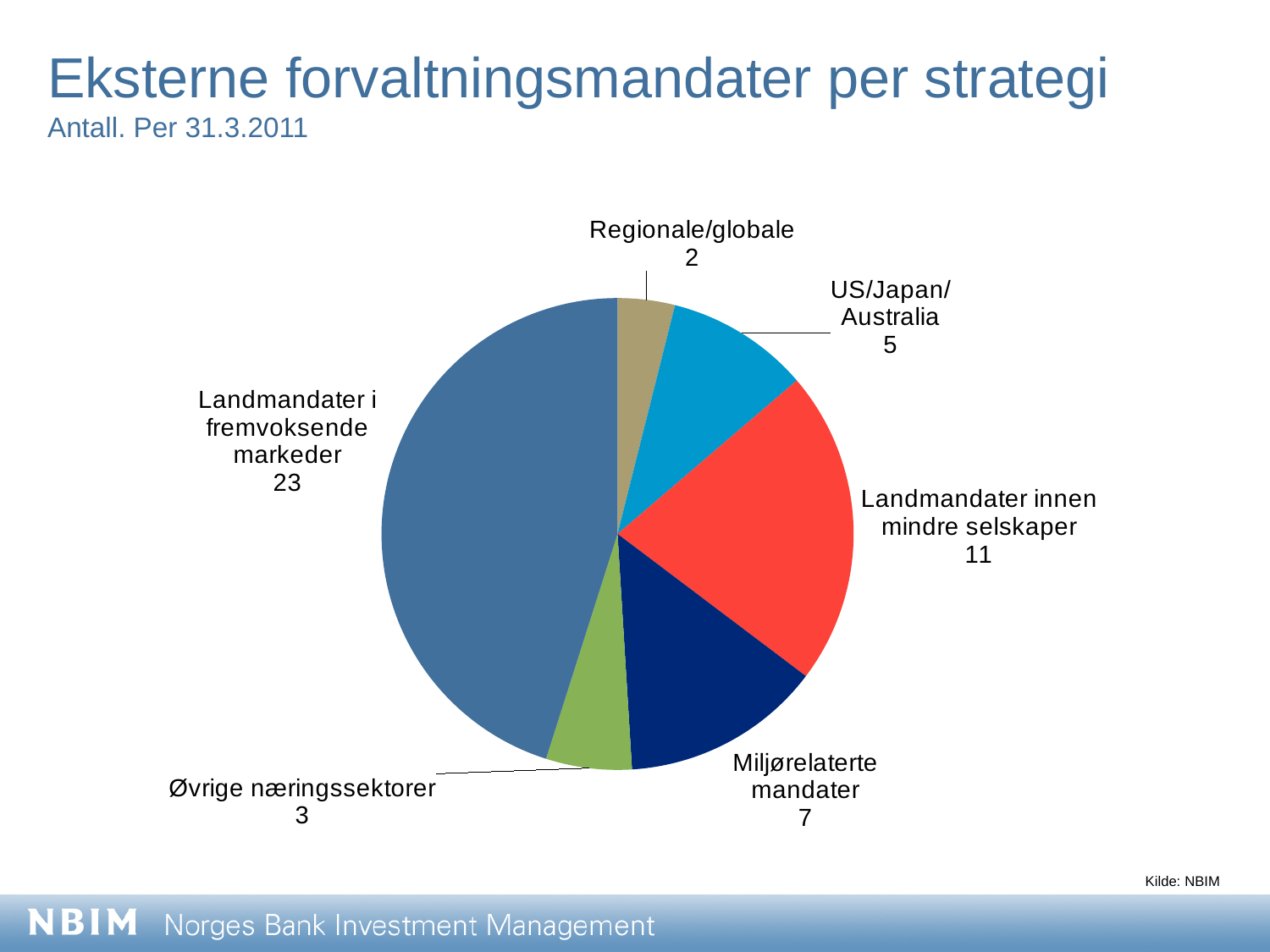
How many external management mandates are in the category 'Landmandater i fremvoksende markeder'? 23 Which category has the largest slice of the pie? Landmandater i fremvoksende markeder What is the difference between the values for 'Landmandater i fremvoksende markeder' and 'Landmandater innen mindre selskaper'? 12 What is the value shown for 'Miljørelaterte mandater'? 7 Which category has the smallest slice of the pie? Regionale/globale What is the title of the chart on the slide? Eksterne forvaltningsmandater per strategi What is the total number of mandates across all slices of the pie? 51 What is the value shown for 'Landmandater innen mindre selskaper'? 11 How many categories are shown in the pie chart? 6 What is the value shown for 'US/Japan/Australia'? 5 Which is larger: 'Miljørelaterte mandater' or 'US/Japan/Australia'? Miljørelaterte mandater What type of chart is shown on the slide? Pie chart